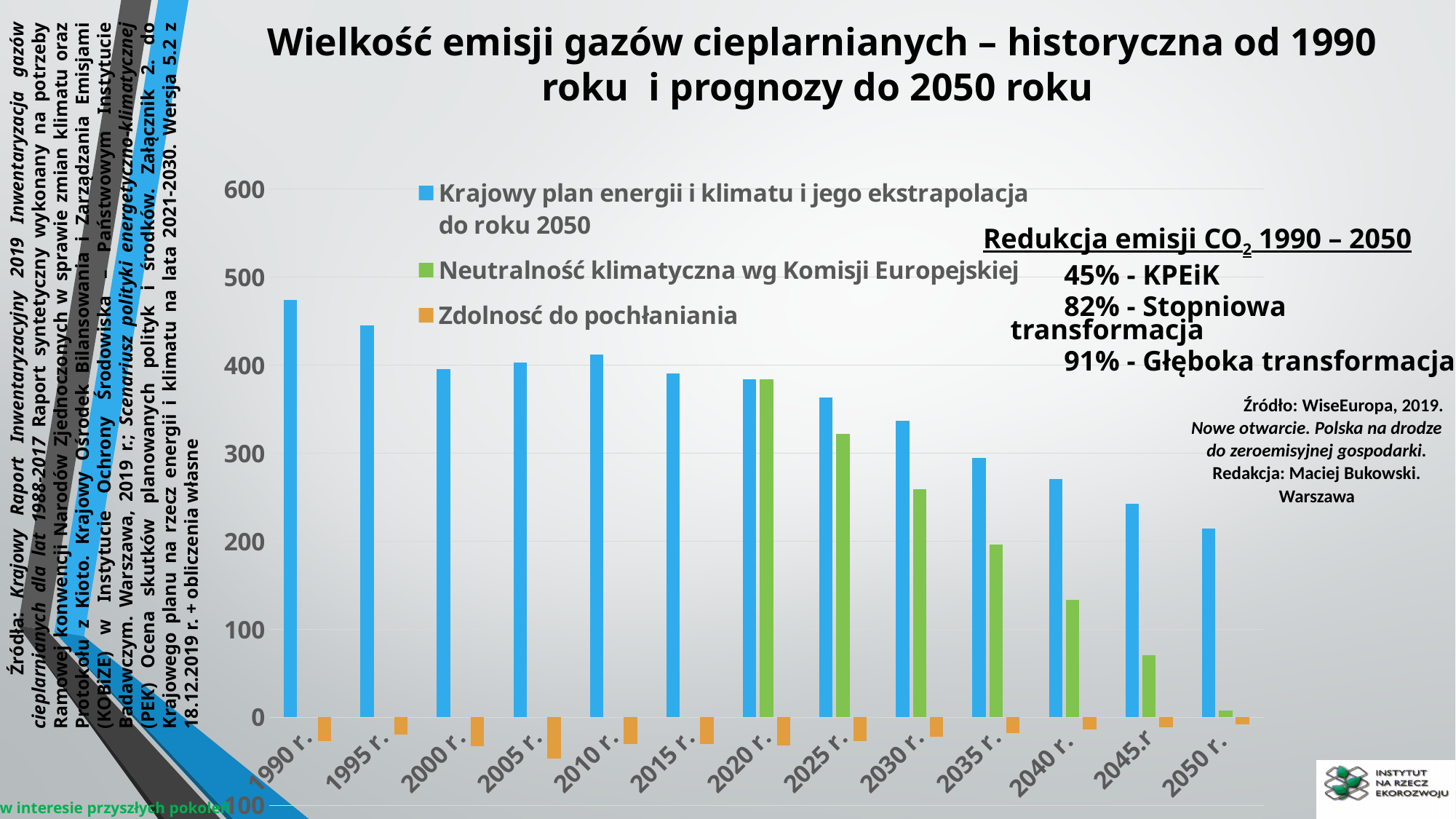
Which year has the lowest value for the series 'Krajowy plan energii i klimatu i jego ekstrapolacja do roku 2050'? 2050 r. What kind of chart is shown on the slide? bar chart Is the value for 'Neutralność klimatyczna wg Komisji Europejskiej' in 2040 r. greater or less than 200? less What colour are the bars for the series 'Zdolność do pochłaniania'? orange In 2035 r., which series has the larger value: 'Krajowy plan energii i klimatu i jego ekstrapolacja do roku 2050' or 'Neutralność klimatyczna wg Komisji Europejskiej'? Krajowy plan energii i klimatu i jego ekstrapolacja do roku 2050 How many series does the legend list? 3 Is the value for 'Krajowy plan energii i klimatu i jego ekstrapolacja do roku 2050' in 2050 r. greater or less than 200? greater Which year is the first in which the series 'Neutralność klimatyczna wg Komisji Europejskiej' appears? 2020 r. Is the value for 'Krajowy plan energii i klimatu i jego ekstrapolacja do roku 2050' in 1990 r. greater or less than 400? greater Which year has the highest value for the series 'Krajowy plan energii i klimatu i jego ekstrapolacja do roku 2050'? 1990 r. Do the values for 'Neutralność klimatyczna wg Komisji Europejskiej' rise or fall from 2020 r. to 2050 r.? fall How many year categories are shown on the x axis? 13